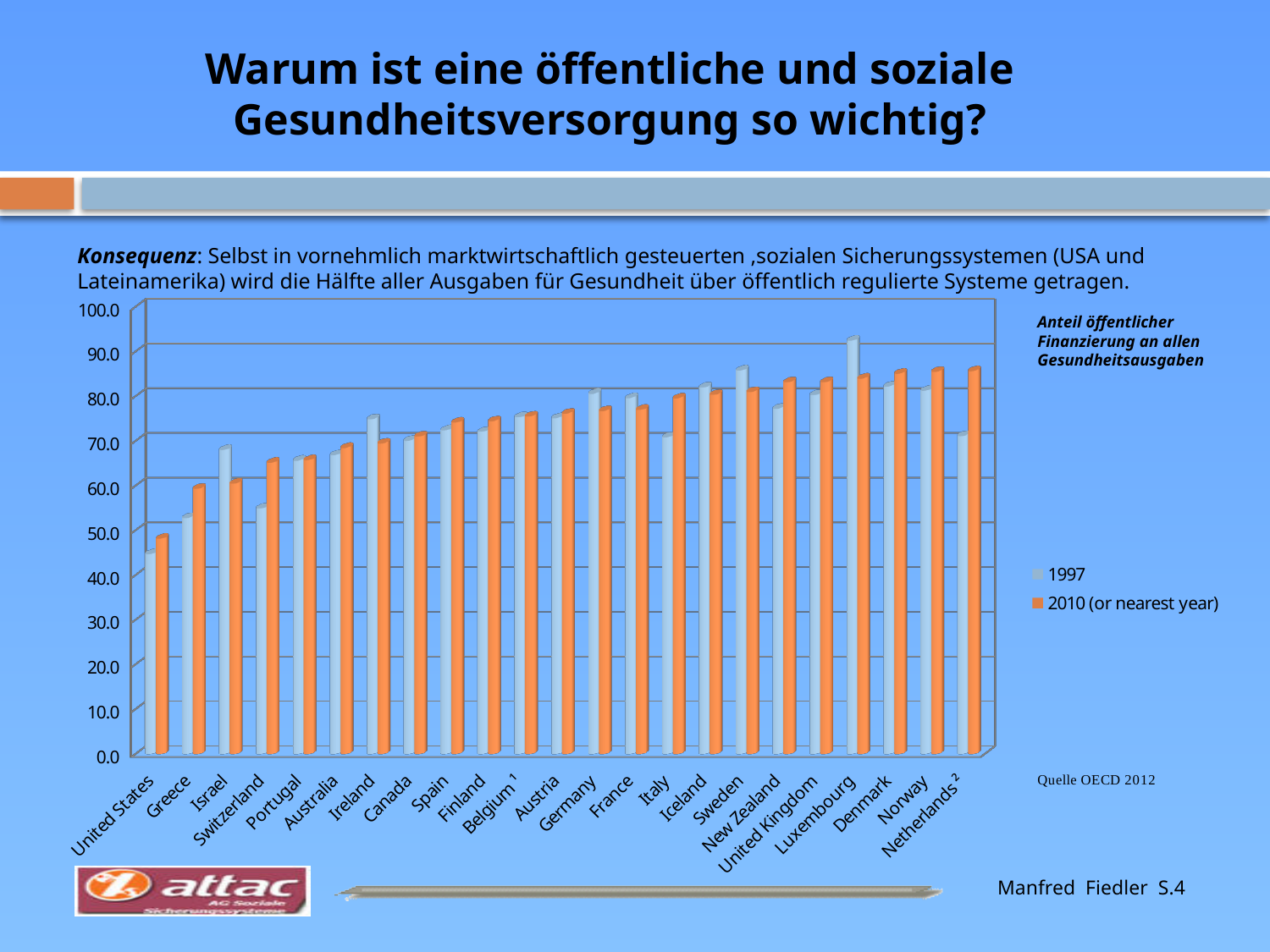
Do the values of the 2010 (or nearest year) series generally rise or fall from left to right along the x axis? Rise Is the 1997 value for the United States greater or less than 50? less Which country has the highest value for the 1997 series? Luxembourg How many series does the chart legend list? 2 How many countries are shown on the x axis of the chart? 23 For Switzerland, which is larger: the 1997 value or the 2010 (or nearest year) value? 2010 (or nearest year) What are the two legend entries of the chart? 1997 and 2010 (or nearest year) Which country has the lowest value for the 1997 series? United States Is the 1997 value for Luxembourg greater or less than 90? greater Is the 2010 (or nearest year) value for the Netherlands greater or less than 80? greater Which country has the lowest value for the 2010 (or nearest year) series? United States What kind of chart is shown on the slide? Bar chart